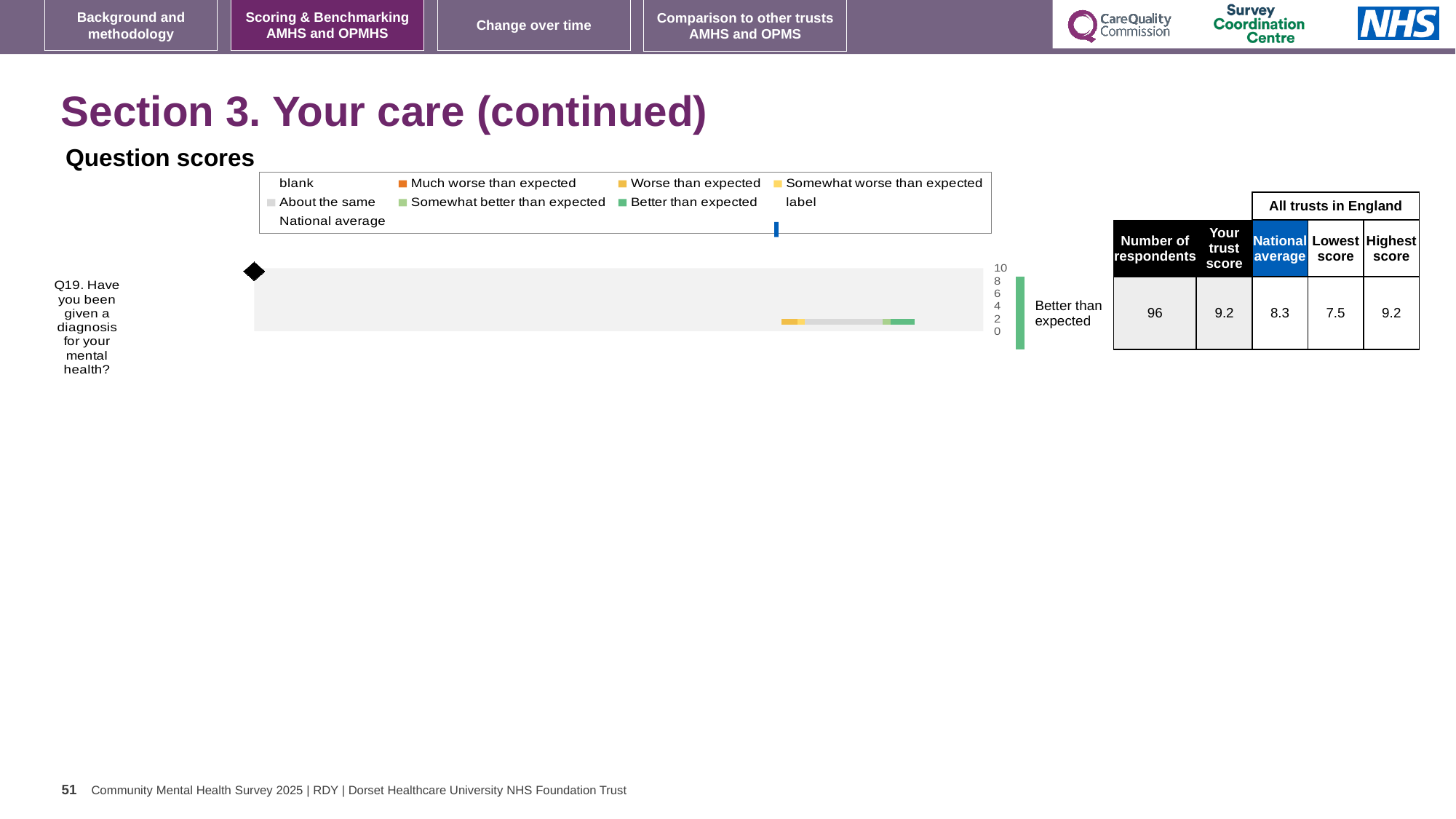
How many questions are plotted in the question scores chart? 1 What benchmark category label is shown next to the bar for Q19? Better than expected What is the lowest score among all trusts in England for Q19? 7.5 What is the trust score for Q19 (Have you been given a diagnosis for your mental health?)? 9.2 Is the trust score for Q19 greater or less than 8? greater What is the difference between the trust score and the national average for Q19? 0.9 What is the national average score for Q19? 8.3 What is the highest score among all trusts in England for Q19? 9.2 What is the difference between the highest and lowest scores for Q19 across all trusts in England? 1.7 What kind of chart is used to show the question scores? Bar chart Which is larger for Q19, the trust score or the national average? Trust score How many respondents answered Q19? 96